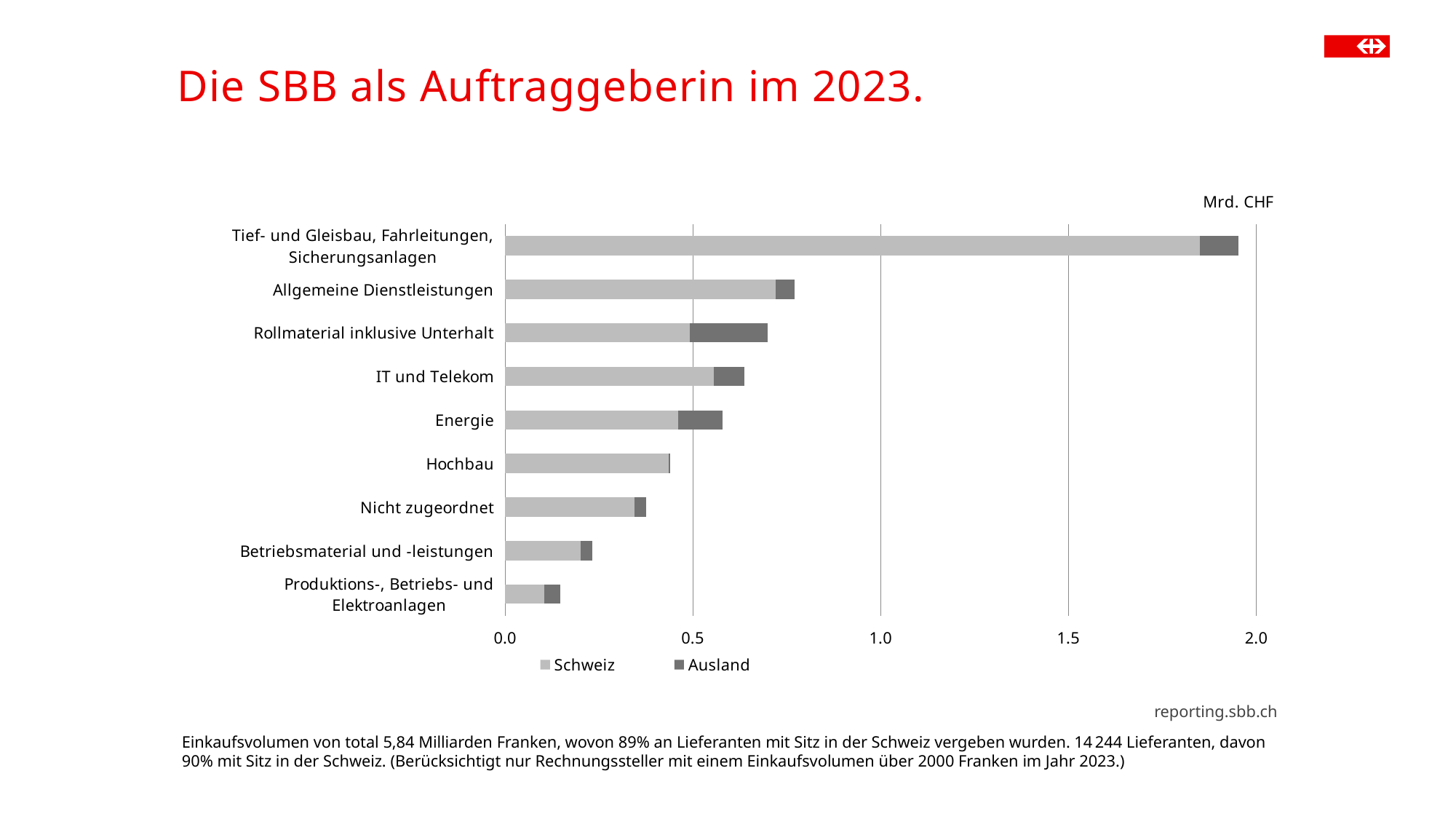
Is the total value for Hochbau greater or less than 0.5? less Is the total value for Allgemeine Dienstleistungen greater or less than 0.5? greater What kind of chart is shown on the slide? Stacked bar chart Which has the larger total value, Allgemeine Dienstleistungen or Rollmaterial inklusive Unterhalt? Allgemeine Dienstleistungen Which category has the lowest total value? Produktions-, Betriebs- und Elektroanlagen How many categories are shown on the chart? 9 What are the two series named in the legend? Schweiz and Ausland Which category has the highest total value? Tief- und Gleisbau, Fahrleitungen, Sicherungsanlagen Is the total value for Tief- und Gleisbau, Fahrleitungen, Sicherungsanlagen greater or less than 1.5? greater Which category has the largest Ausland segment? Rollmaterial inklusive Unterhalt What unit is shown for the values on the chart? Mrd. CHF How many series does the legend list? 2